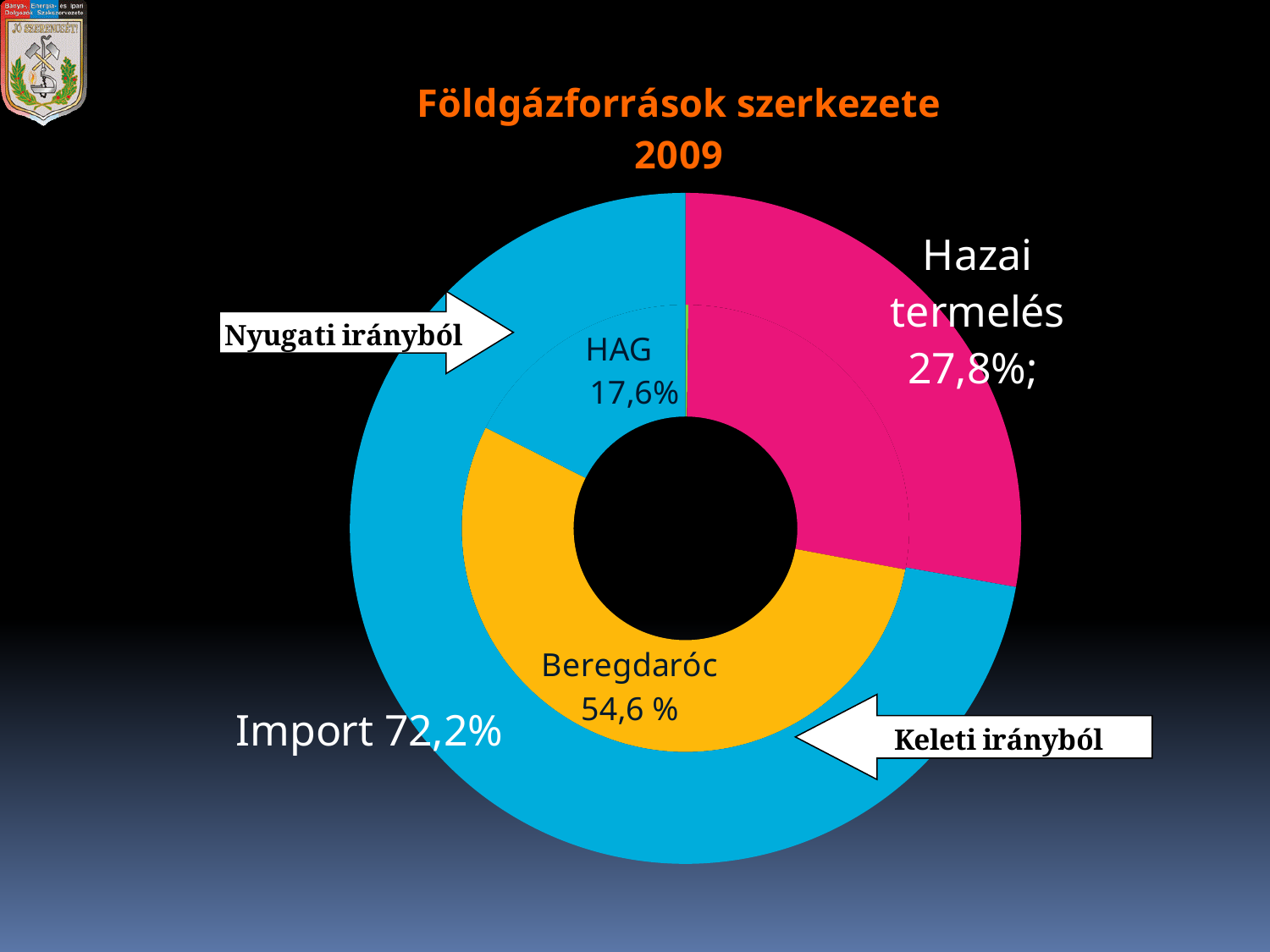
Which direction does the arrow labelled 'Keleti irányból' point to, the Beregdaróc segment or the HAG segment? Beregdaróc What share does Import have in the chart? 72,2% What is the title of the chart? Földgázforrások szerkezete 2009 What share is shown for Beregdaróc? 54,6 % What share does Hazai termelés have in the chart? 27,8% Which is larger, Beregdaróc or HAG? Beregdaróc What share is shown for HAG? 17,6% What is the difference in percentage points between Import and Hazai termelés? 44,4 Which of the inner-ring import sources (HAG, Beregdaróc) has the smallest share? HAG What is the difference in percentage points between Beregdaróc and HAG? 37,0 What kind of chart is shown on the slide? doughnut chart Which is larger, Import or Hazai termelés? Import